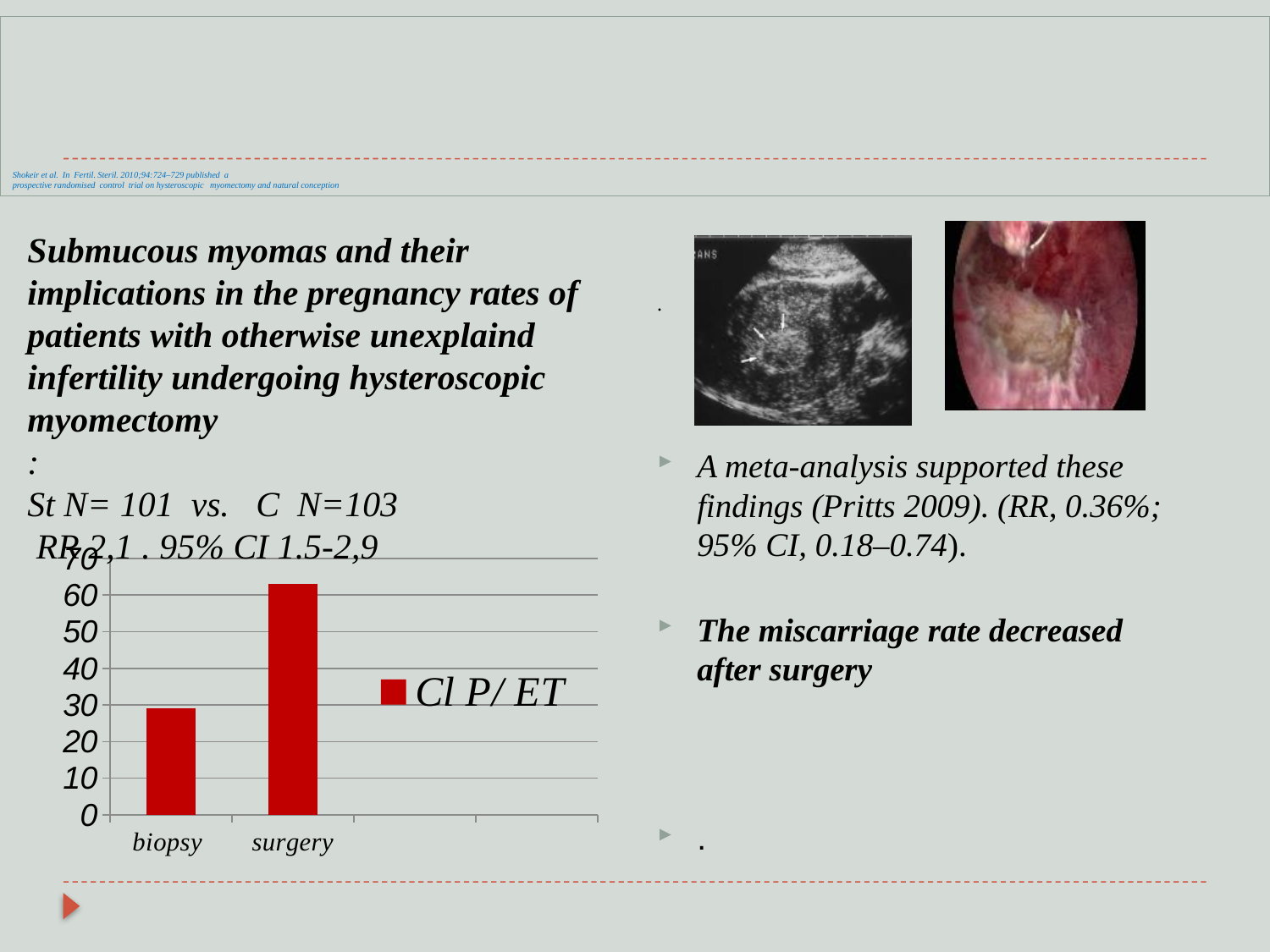
Is the value for surgery greater or less than 70? less How many series does the chart's legend list? 1 What series name is shown in the chart's legend? Cl P/ ET Which category has the highest bar in the chart? surgery What kind of chart is shown on the slide? bar chart Is the value for biopsy greater or less than 40? less Is the value for biopsy greater or less than 20? greater Which category has the lowest bar in the chart? biopsy Which is larger, the value for biopsy or the value for surgery? surgery How many categories are plotted on the x axis of the chart? 2 What colour are the bars in the chart? red